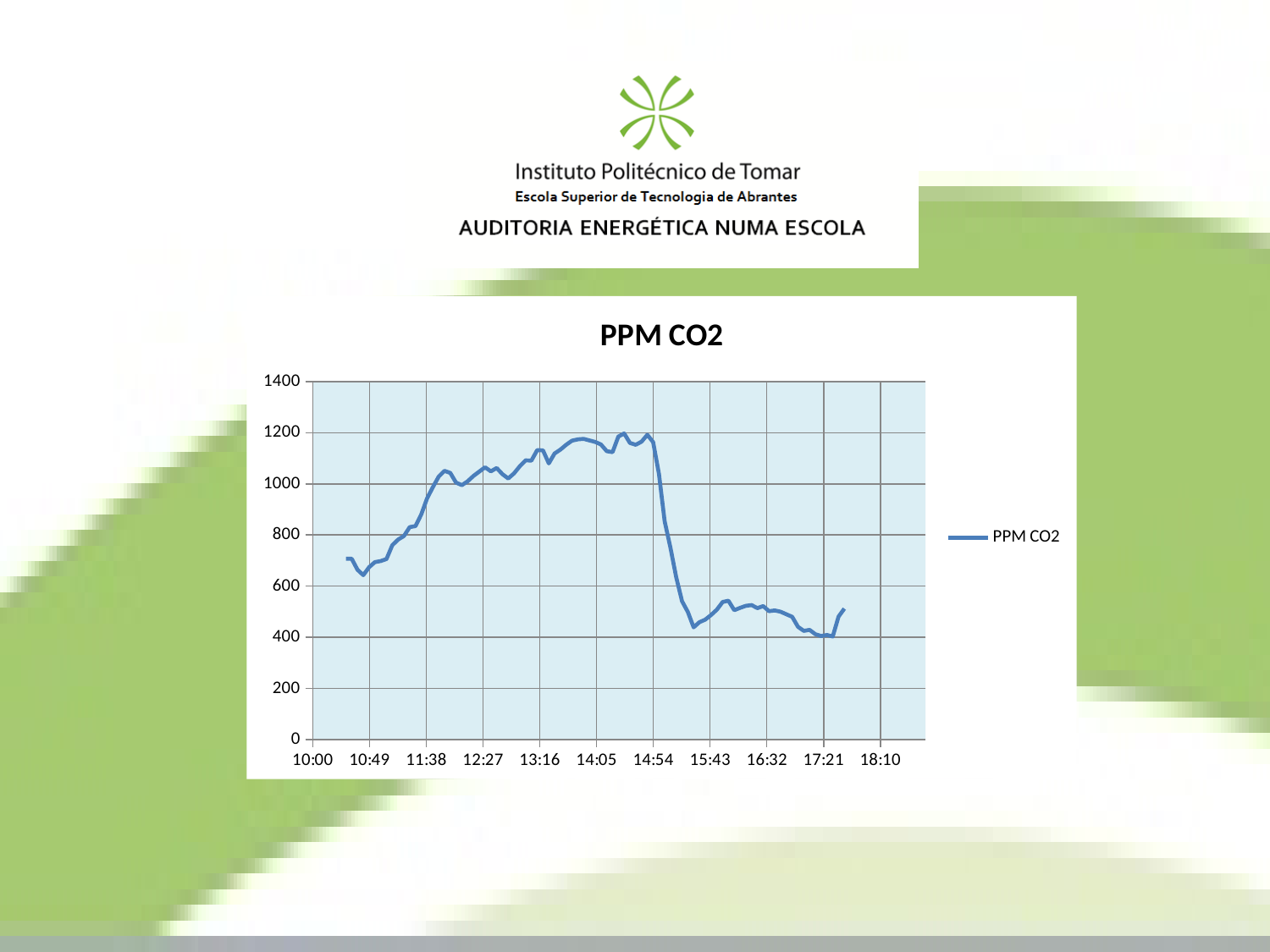
Is the value for PPM CO2 at 16:32 greater or less than 600? less What kind of chart is shown on the slide? line chart Is the value for PPM CO2 at 14:05 greater or less than 1000? greater Is the value for PPM CO2 at 10:49 greater or less than 800? less Between 14:54 and 15:43, does the PPM CO2 value rise or fall? fall How many series does the legend list? 1 What is the title of the chart? PPM CO2 How many time labels are shown on the x axis? 11 What is the name of the series shown in the legend? PPM CO2 Between 10:49 and 12:27, does the PPM CO2 value rise or fall? rise